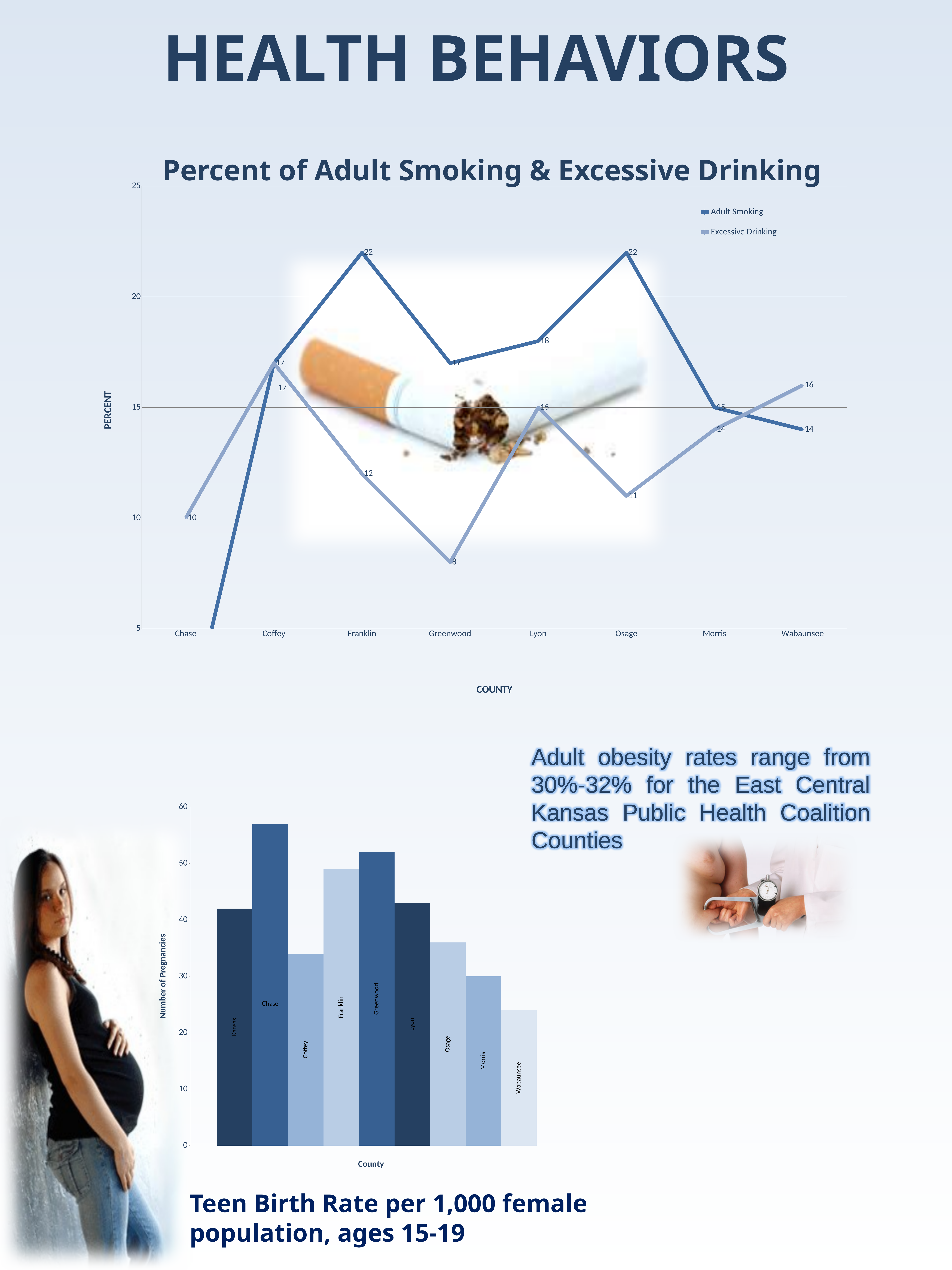
How many counties are shown on the x axis of the 'Percent of Adult Smoking & Excessive Drinking' chart? 8 In the 'Percent of Adult Smoking & Excessive Drinking' chart, what is the Excessive Drinking value for Greenwood? 8 In the Teen Birth Rate bar chart at the bottom of the slide, which county has the shortest bar? Wabaunsee In the 'Percent of Adult Smoking & Excessive Drinking' chart, which is larger for Wabaunsee: Adult Smoking or Excessive Drinking? Excessive Drinking In the 'Percent of Adult Smoking & Excessive Drinking' chart, which county has the lowest Excessive Drinking value? Greenwood In the 'Percent of Adult Smoking & Excessive Drinking' chart, what is the difference between the Adult Smoking and Excessive Drinking values for Osage? 11 In the Teen Birth Rate bar chart at the bottom of the slide, is the value for Morris greater or less than 40? less What kind of chart is the 'Percent of Adult Smoking & Excessive Drinking' chart? Line chart In the 'Percent of Adult Smoking & Excessive Drinking' chart, what is the Adult Smoking value for Franklin? 22 How many series does the legend of the 'Percent of Adult Smoking & Excessive Drinking' chart list? 2 In the Teen Birth Rate bar chart at the bottom of the slide, which county has the tallest bar? Chase In the 'Percent of Adult Smoking & Excessive Drinking' chart, what is the Excessive Drinking value for Wabaunsee? 16